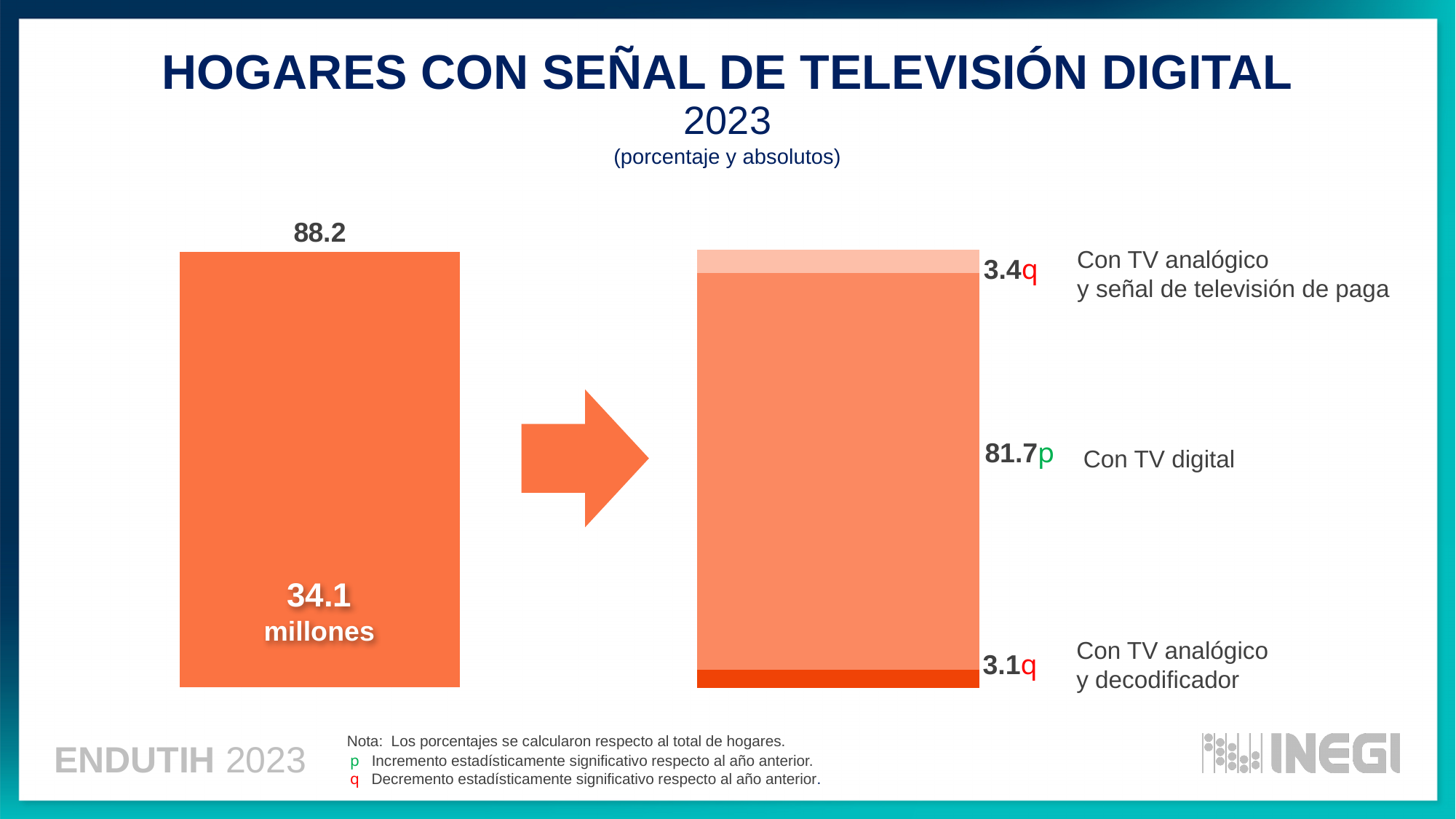
Which segment of the stacked bar on the right has the highest value? Con TV digital In the stacked bar on the right, what is the value for 'Con TV analógico y decodificador'? 3.1 Which segment in the stacked bar is marked with a green 'p', indicating a statistically significant increase from the previous year? Con TV digital In the stacked bar on the right, what is the value for 'Con TV analógico y señal de televisión de paga'? 3.4 What kind of chart is shown on the slide? Bar chart What is the difference between the 'Con TV digital' value and the 'Con TV analógico y señal de televisión de paga' value in the stacked bar? 78.3 What percentage of households have a digital television signal, as shown on the left bar? 88.2 Which segment of the stacked bar on the right has the lowest value? Con TV analógico y decodificador How many households (in absolute terms) have a digital television signal, as labelled inside the left bar? 34.1 millones What is the total of the three segments in the stacked bar on the right? 88.2 In the stacked bar on the right, what is the value for 'Con TV digital'? 81.7 How many segments does the stacked bar on the right contain? 3